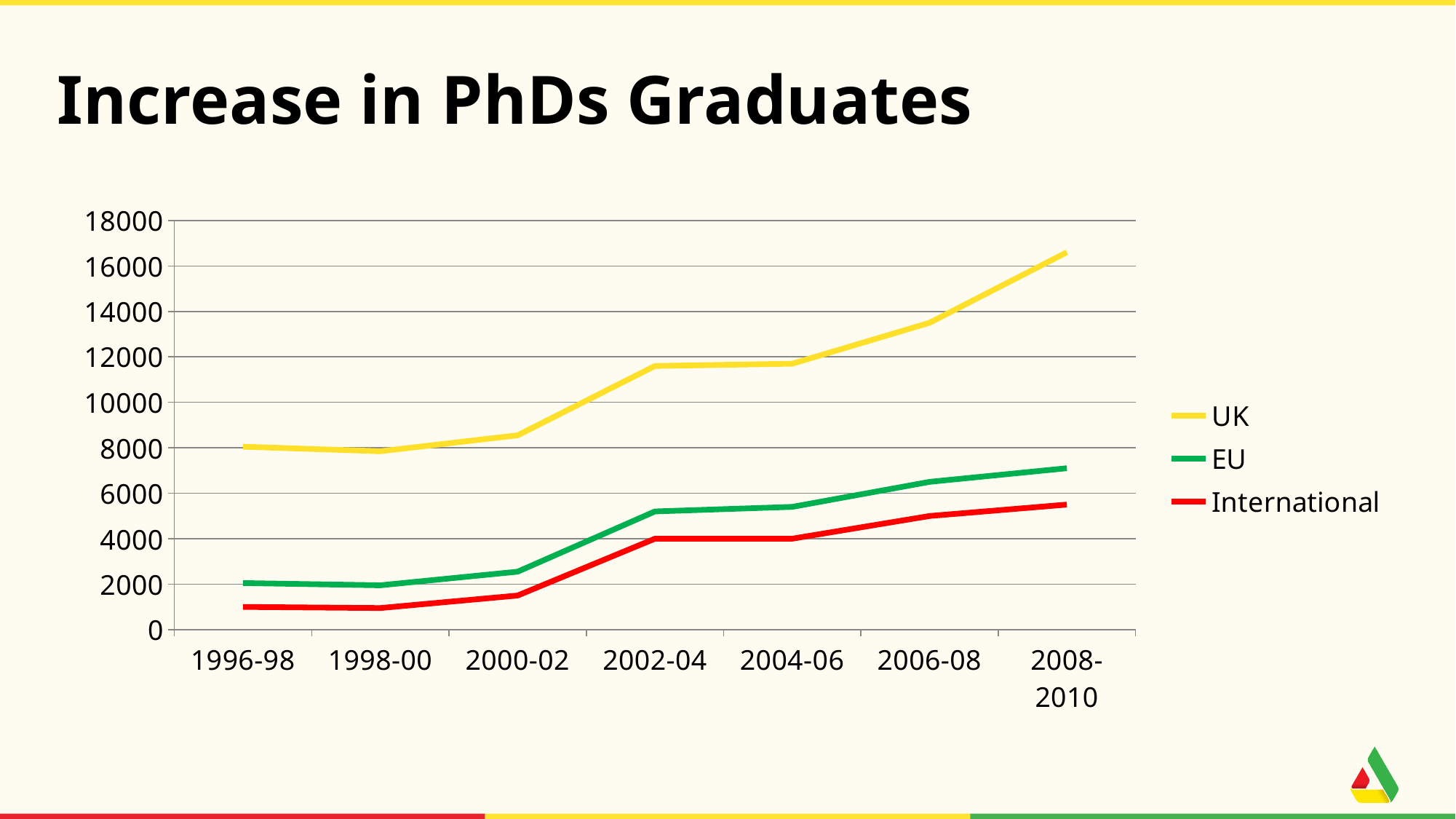
Is the UK value for 2002-04 greater or less than 10000? greater Which series has the highest value in 2008-2010? UK In 2002-04, which is larger, the EU value or the International value? EU Is the EU value for 2008-2010 greater or less than 8000? less How many series does the legend list? 3 Is the UK value for 2008-2010 greater or less than 16000? greater What colour is the line for the UK series? yellow What kind of chart is shown on the slide? line chart Does the UK series rise or fall from 2002-04 to 2008-2010? rise How many time periods are shown on the x axis? 7 Which series has the lowest value in 1996-98? International